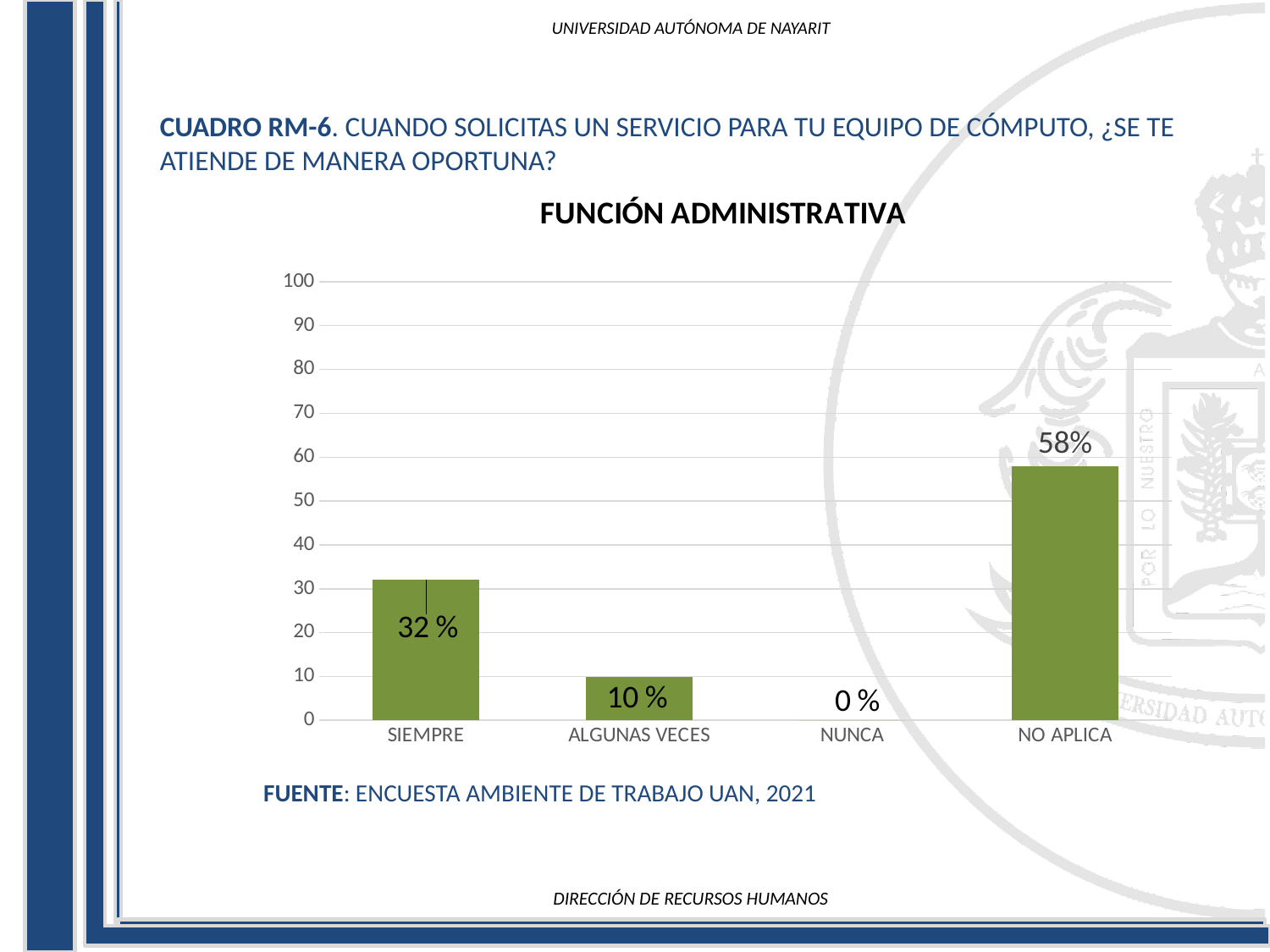
Is the value for NO APLICA greater or less than 50? greater Which category has the highest value? NO APLICA What kind of chart is shown on the slide? bar chart What is the title of the chart? FUNCIÓN ADMINISTRATIVA How many categories are shown on the x axis? 4 What is the value for ALGUNAS VECES? 10 % What is the value for SIEMPRE? 32 % Which is larger, the value for SIEMPRE or the value for ALGUNAS VECES? SIEMPRE What is the difference between the values for NO APLICA and SIEMPRE? 26 Which category has the lowest value? NUNCA What is the value for NO APLICA? 58% What is the value for NUNCA? 0 %